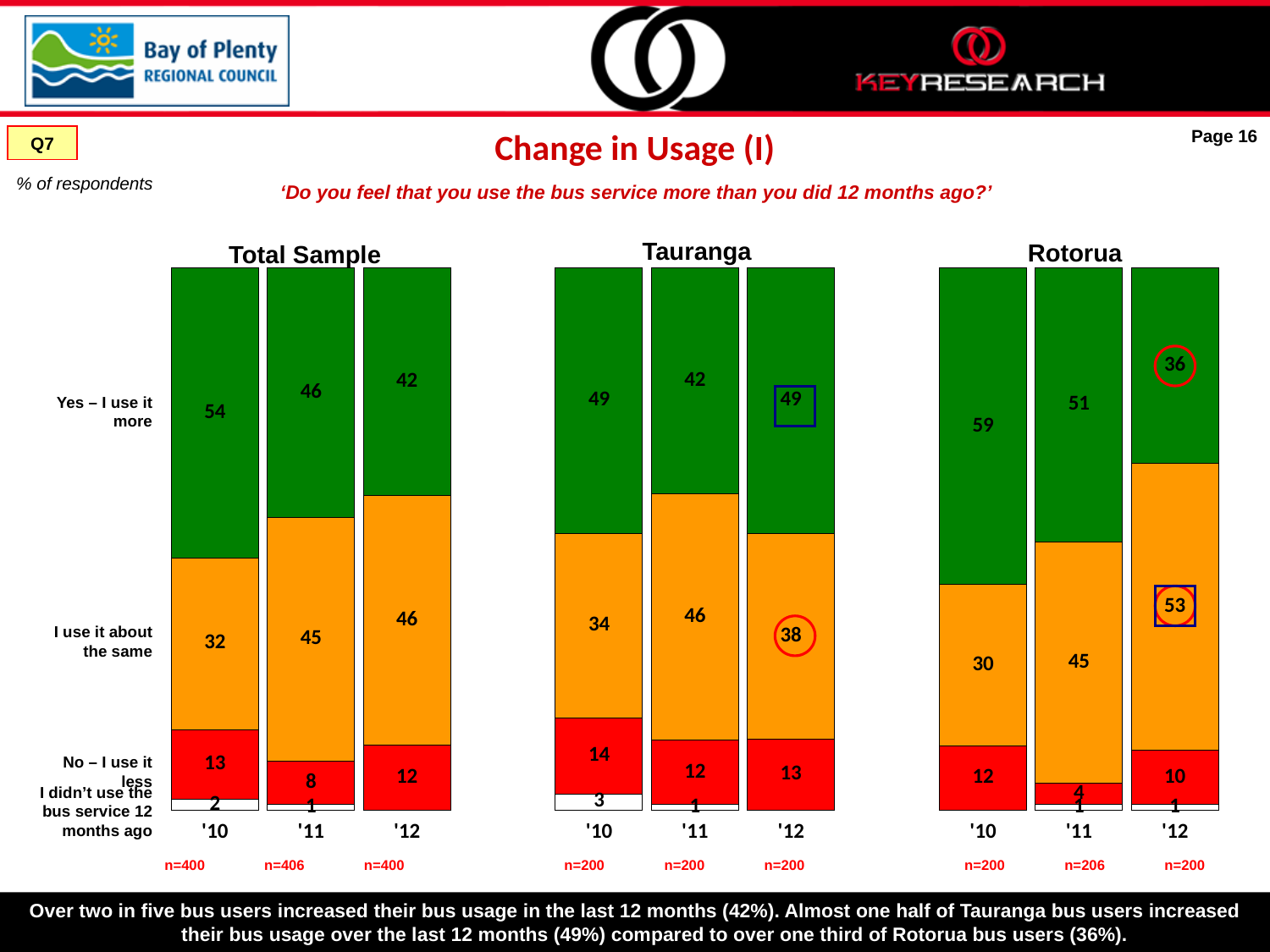
In the Rotorua chart, what is the value for 'Yes – I use it more' in '12? 36 How many years (bars) are shown in the Tauranga chart? 3 What is the sample size (n) shown for the '11 bar in the Rotorua chart? n=206 In the Total Sample chart, does the 'Yes – I use it more' value rise or fall from '10 to '12? Fall What type of chart is used for the Total Sample? Stacked bar chart In the Total Sample chart, what percentage of respondents in '10 said 'Yes – I use it more'? 54 In the Tauranga chart, what is the value for 'I use it about the same' in '12? 38 In the Tauranga chart, what is the difference between the 'Yes – I use it more' values for '12 and '11? 7 In the Total Sample chart, which year has the highest value for 'Yes – I use it more'? '10 In the Rotorua chart, which year has the lowest value for 'Yes – I use it more'? '12 In the Rotorua chart, what is the value for 'No – I use it less' in '11? 4 In the Rotorua chart, which is larger: 'I use it about the same' in '12 or 'Yes – I use it more' in '12? I use it about the same